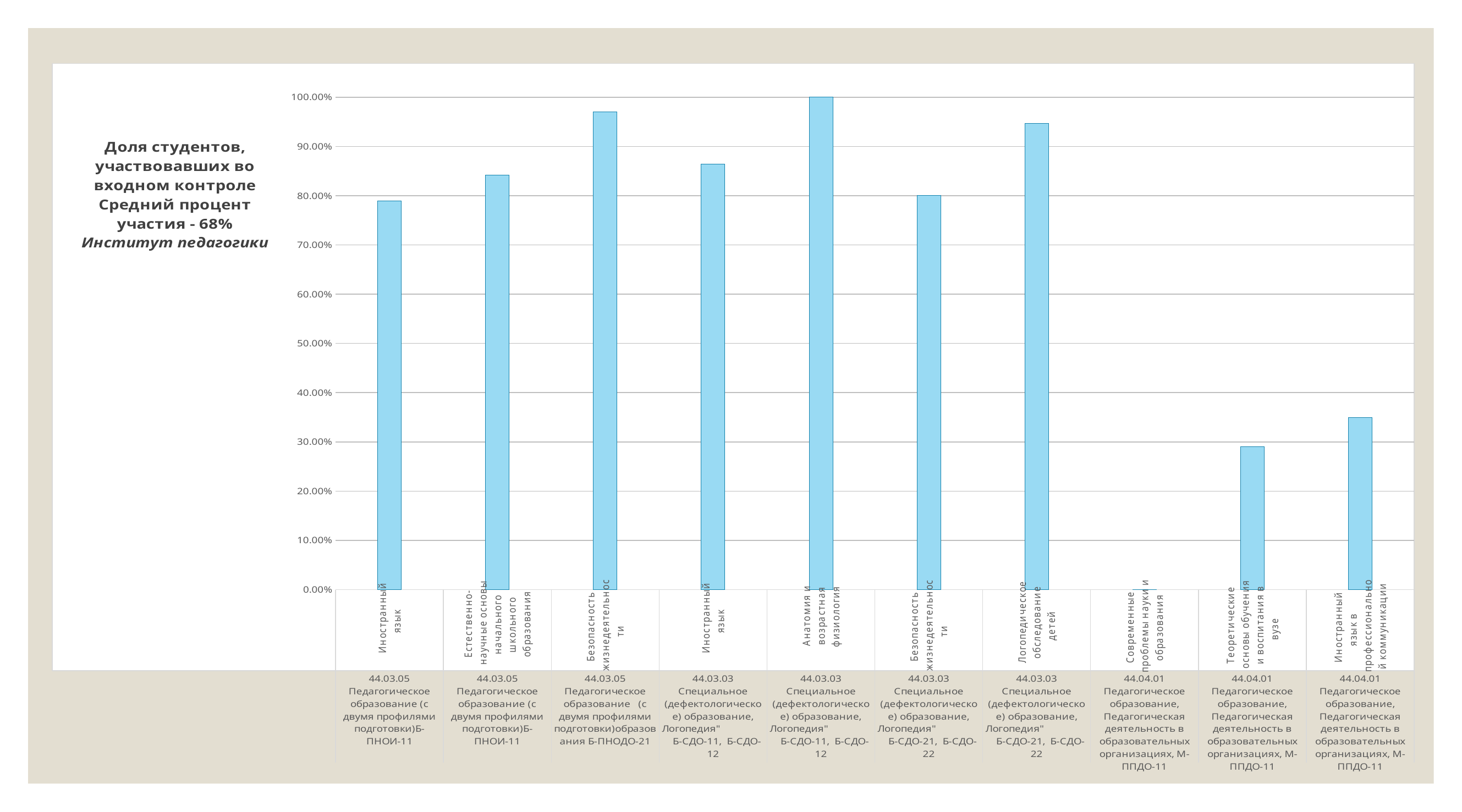
Which is larger: the value for Безопасность жизнедеятельности in group Б-ПНОДО-21 (44.03.05) or in group Б-СДО-21, Б-СДО-22 (44.03.03)? Б-ПНОДО-21 (44.03.05) What is the title of the chart? Доля студентов, участвовавших во входном контроле How many categories (bars) does the chart have? 10 What average participation percentage is stated in the chart title text? 68% Which category has the highest value in the chart? Анатомия и возрастная физиология (44.03.03, Б-СДО-11, Б-СДО-12) Is the value for Теоретические основы обучения и воспитания в вузе (44.04.01, М-ППДО-11) greater or less than 40.00%? less Which category has the lowest value in the chart? Современные проблемы науки и образования (44.04.01, М-ППДО-11) Is the value for Безопасность жизнедеятельности (44.03.05, Б-ПНОДО-21) greater or less than 90.00%? greater What is the value for Анатомия и возрастная физиология (44.03.03, Б-СДО-11, Б-СДО-12)? 100.00% What kind of chart is shown on the slide? bar chart Is the value for Иностранный язык в профессиональной коммуникации (44.04.01, М-ППДО-11) greater or less than 50.00%? less